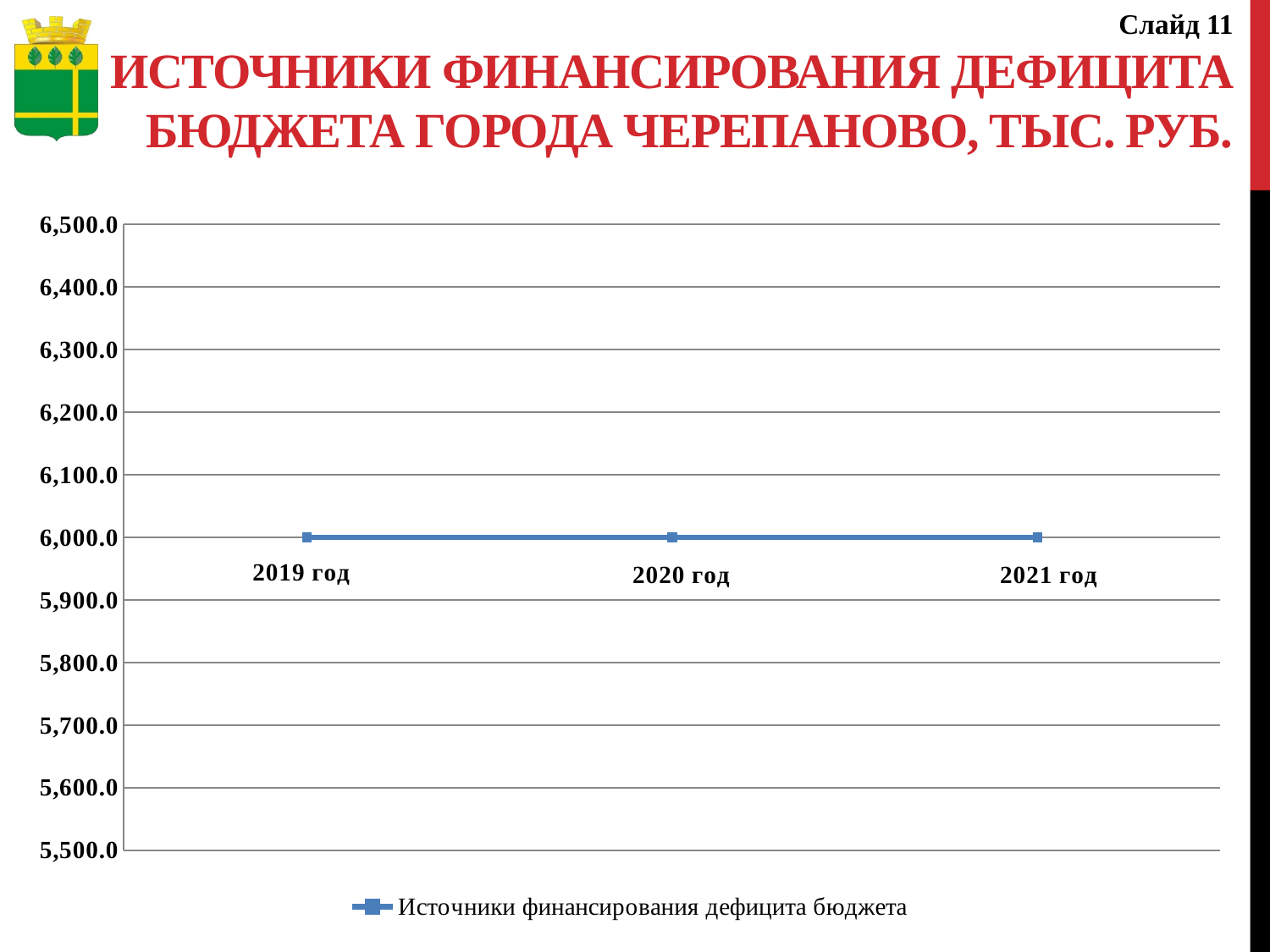
How many series does the chart legend list? 1 How many years are plotted on the x axis of the chart? 3 Do the values rise, fall or stay flat from 2019 год to 2021 год? stay flat What kind of chart is shown on the slide? line chart What is the value for 2019 год? 6,000.0 What is the difference between the values for 2019 год and 2021 год? 0.0 Is the value for 2021 год greater or less than 5,500.0? greater What is the value for 2020 год? 6,000.0 What is the value for 2021 год? 6,000.0 Is the value for 2020 год greater or less than 6,500.0? less What is the name of the series shown in the chart legend? Источники финансирования дефицита бюджета What is the lowest value shown on the y axis of the chart? 5,500.0